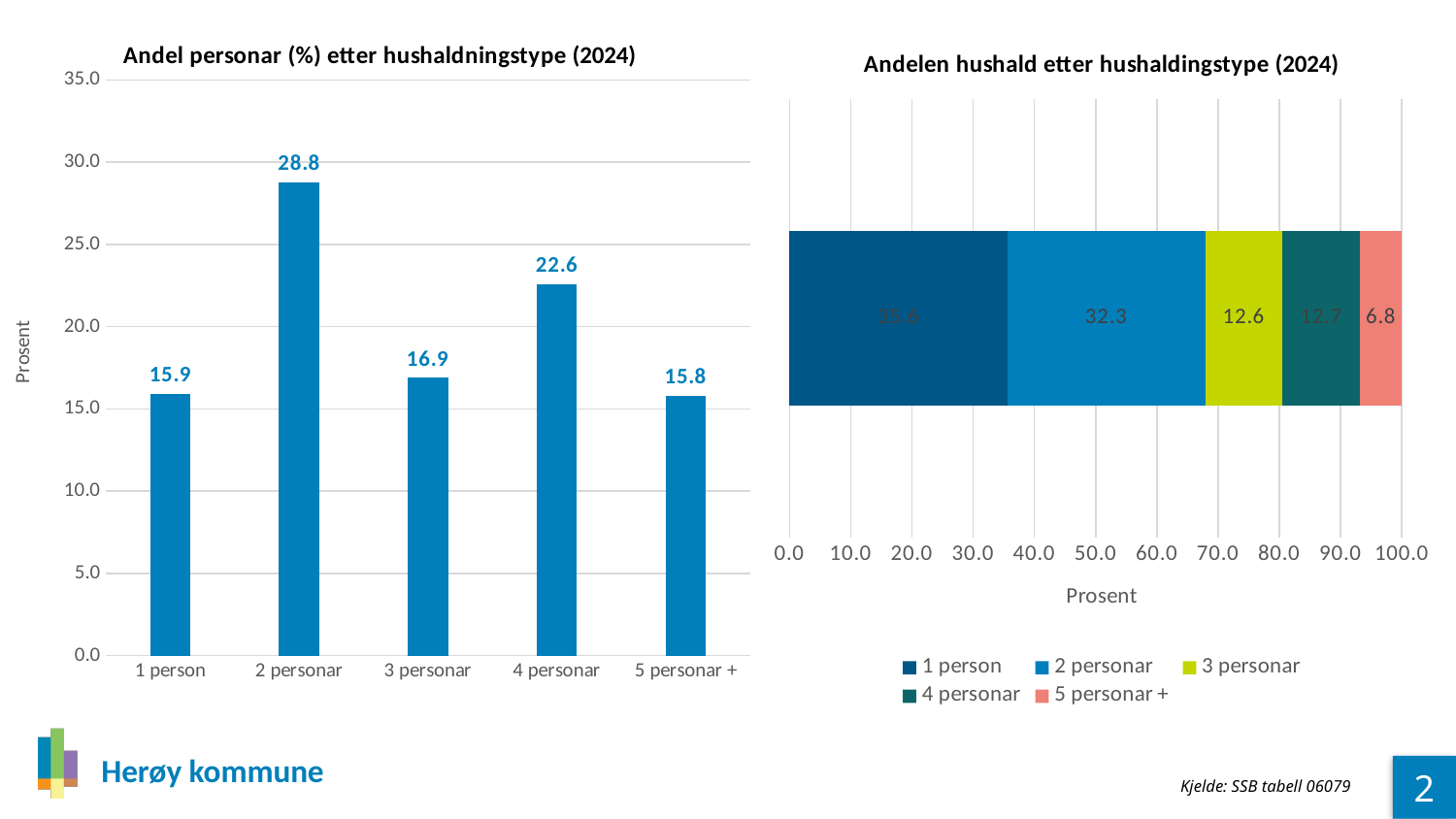
What kind of chart is 'Andel personar (%) etter hushaldningstype (2024)'? Bar chart In the chart 'Andel personar (%) etter hushaldningstype (2024)', which is larger: the value for 3 personar or the value for 4 personar? 4 personar In the chart 'Andel personar (%) etter hushaldningstype (2024)', which category has the highest value? 2 personar In the chart 'Andelen hushald etter hushaldingstype (2024)', what colour is the 3 personar segment? Yellow-green In the chart 'Andel personar (%) etter hushaldningstype (2024)', what is the difference between the values for 2 personar and 4 personar? 6.2 In the chart 'Andel personar (%) etter hushaldningstype (2024)', how many categories are shown on the x axis? 5 In the chart 'Andelen hushald etter hushaldingstype (2024)', what is the value for 5 personar +? 6.8 In the chart 'Andel personar (%) etter hushaldningstype (2024)', which category has the lowest value? 5 personar + In the chart 'Andel personar (%) etter hushaldningstype (2024)', what is the value for 2 personar? 28.8 In the chart 'Andel personar (%) etter hushaldningstype (2024)', what is the value for 5 personar +? 15.8 In the chart 'Andelen hushald etter hushaldingstype (2024)', how many series does the legend list? 5 In the chart 'Andelen hushald etter hushaldingstype (2024)', what is the value for 2 personar? 32.3